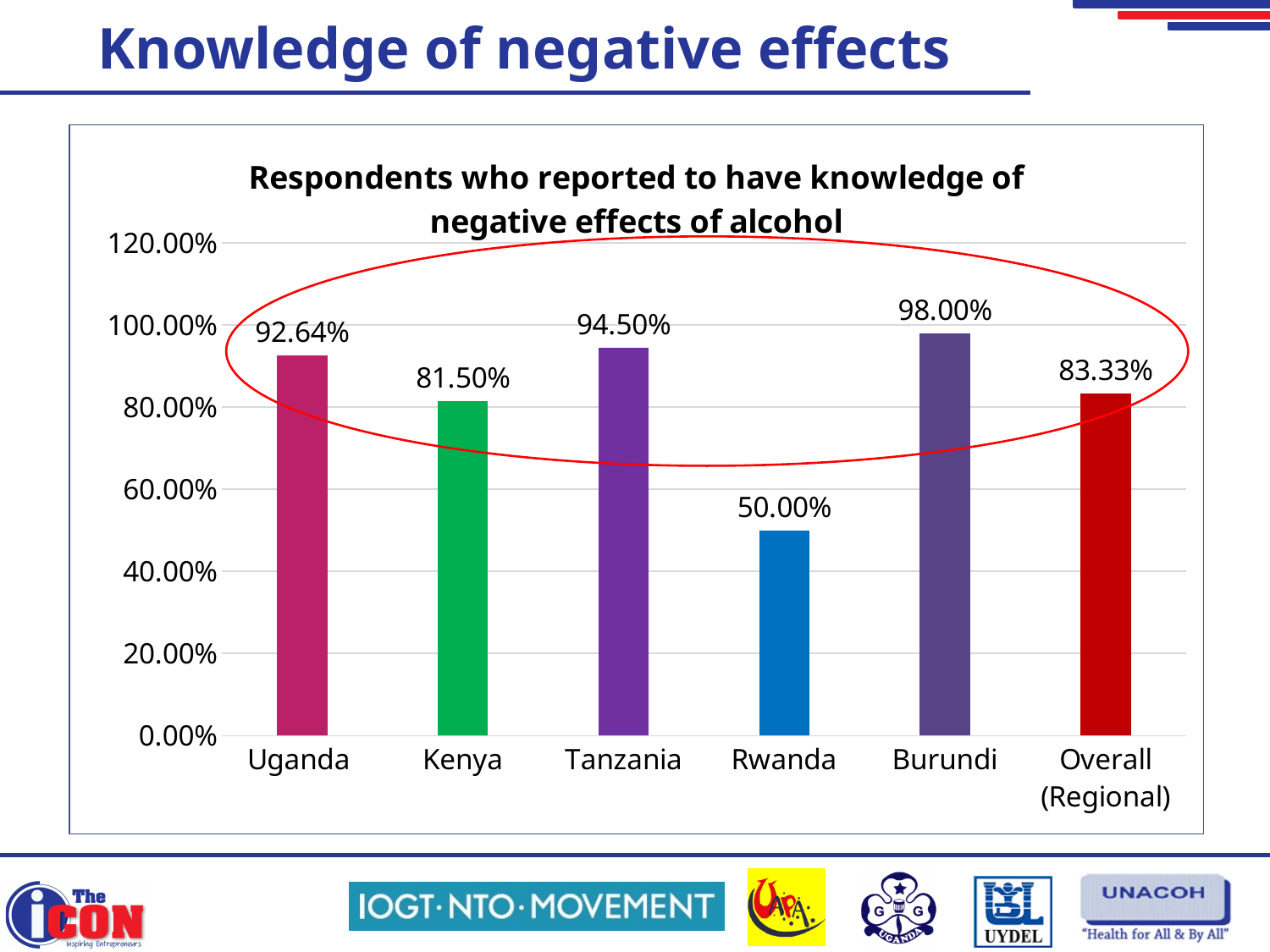
What is the value shown for Overall (Regional)? 83.33% Which country has the highest percentage of respondents reporting knowledge of negative effects of alcohol? Burundi Is the value for Kenya greater or less than 80.00%? greater What is the difference between the values for Tanzania and Kenya? 13.00% What is the value shown for Rwanda? 50.00% What is the difference between the values for Burundi and Rwanda? 48.00% What is the title of the chart? Respondents who reported to have knowledge of negative effects of alcohol What percentage of respondents in Uganda reported knowledge of negative effects of alcohol? 92.64% What kind of chart is shown on the slide? Bar chart Which category has the lowest value in the chart? Rwanda Which is larger, the value for Uganda or the value for Tanzania? Tanzania How many categories are shown on the x axis of the chart? 6